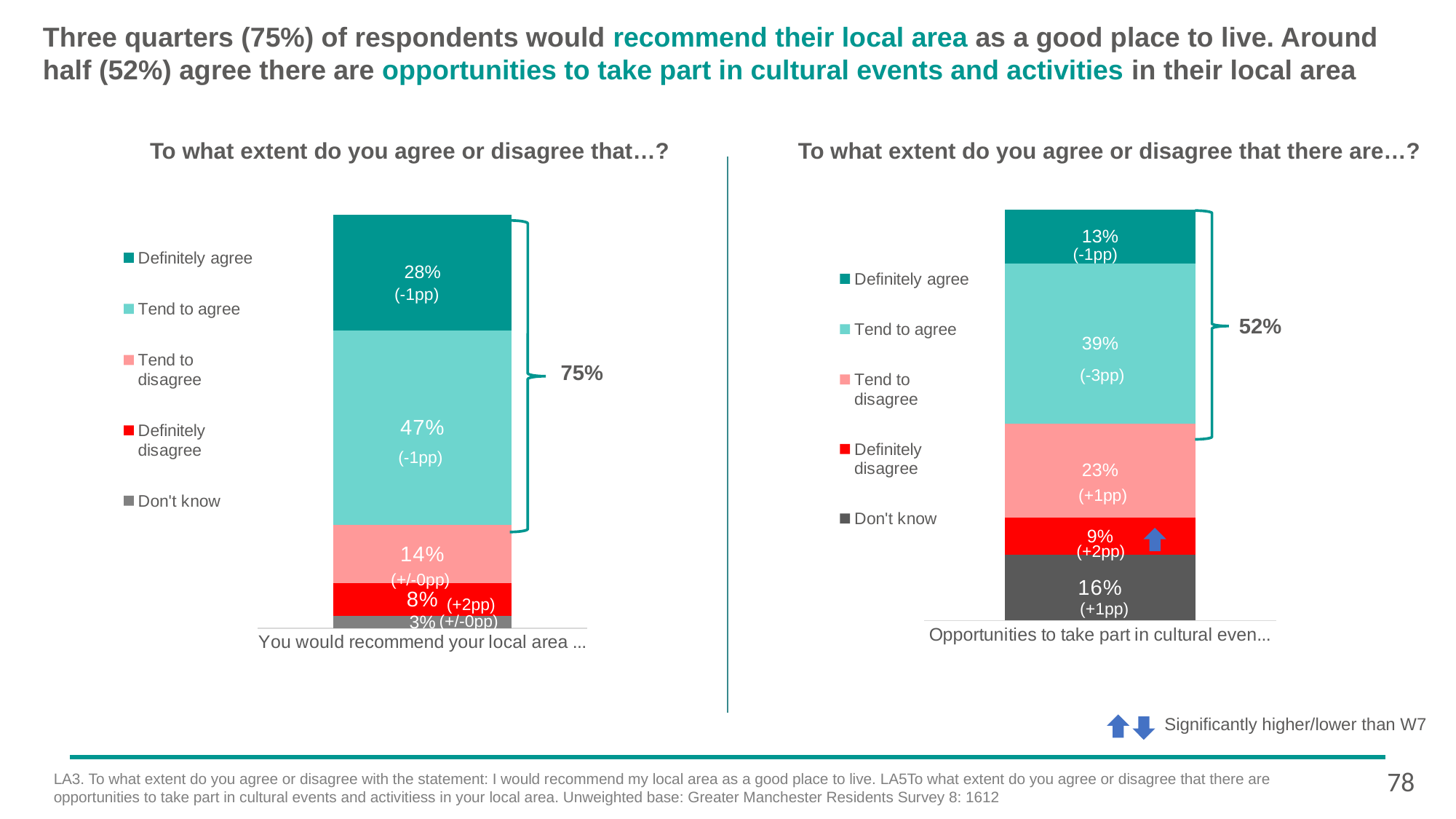
In the left chart, which response category has the largest share? Tend to agree In the right chart, what percentage of respondents answered 'Don't know'? 16% In the left chart, which response category has the smallest share? Don't know In the left chart, what percentage of respondents 'Tend to agree'? 47% In the right chart, what percentage of respondents 'Tend to disagree' that there are opportunities to take part in cultural events? 23% In the right chart, what is the difference between the 'Tend to agree' and 'Definitely agree' percentages? 26% In the right chart, what combined percentage is shown by the bracket for 'Definitely agree' and 'Tend to agree'? 52% In the right chart, which response category has the smallest share? Definitely disagree Which is larger in the left chart: 'Tend to disagree' or 'Definitely disagree'? Tend to disagree What type of chart is shown on the left side of the slide? Stacked bar chart In the left chart, what percentage of respondents 'Definitely agree' that they would recommend their local area? 28% How many series does the legend of the right chart list? 5